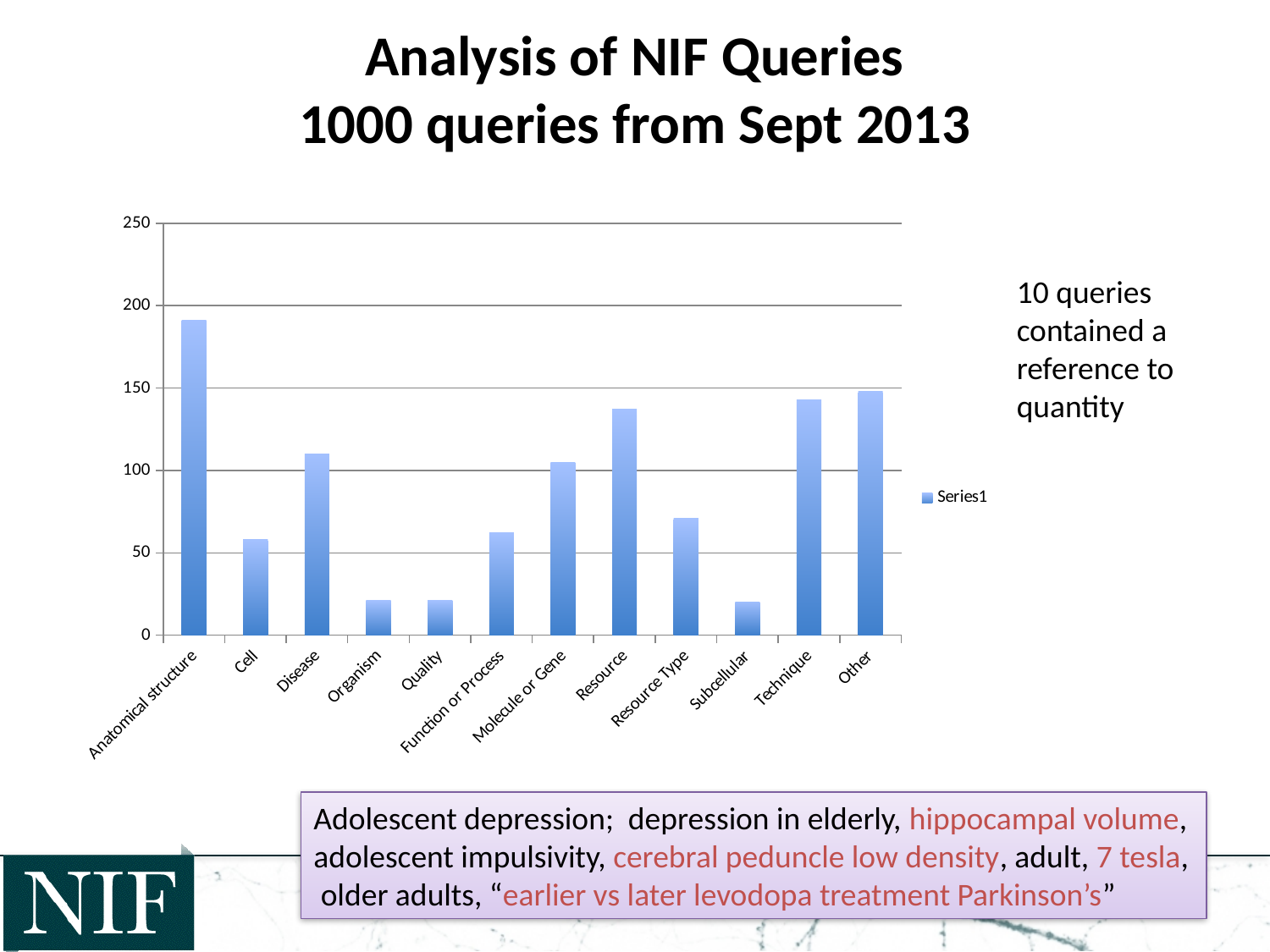
Is the value for Disease greater or less than 100? greater Which has a larger value, Cell or Molecule or Gene? Molecule or Gene Is the value for Anatomical structure greater or less than 150? greater What is the name of the series shown in the chart's legend? Series1 Is the value for Resource greater or less than 150? less Which category has the highest value in the chart? Anatomical structure Which has a larger value, Resource or Disease? Resource How many categories are shown on the x axis of the chart? 12 What kind of chart is shown on the slide? bar chart How many series does the chart's legend list? 1